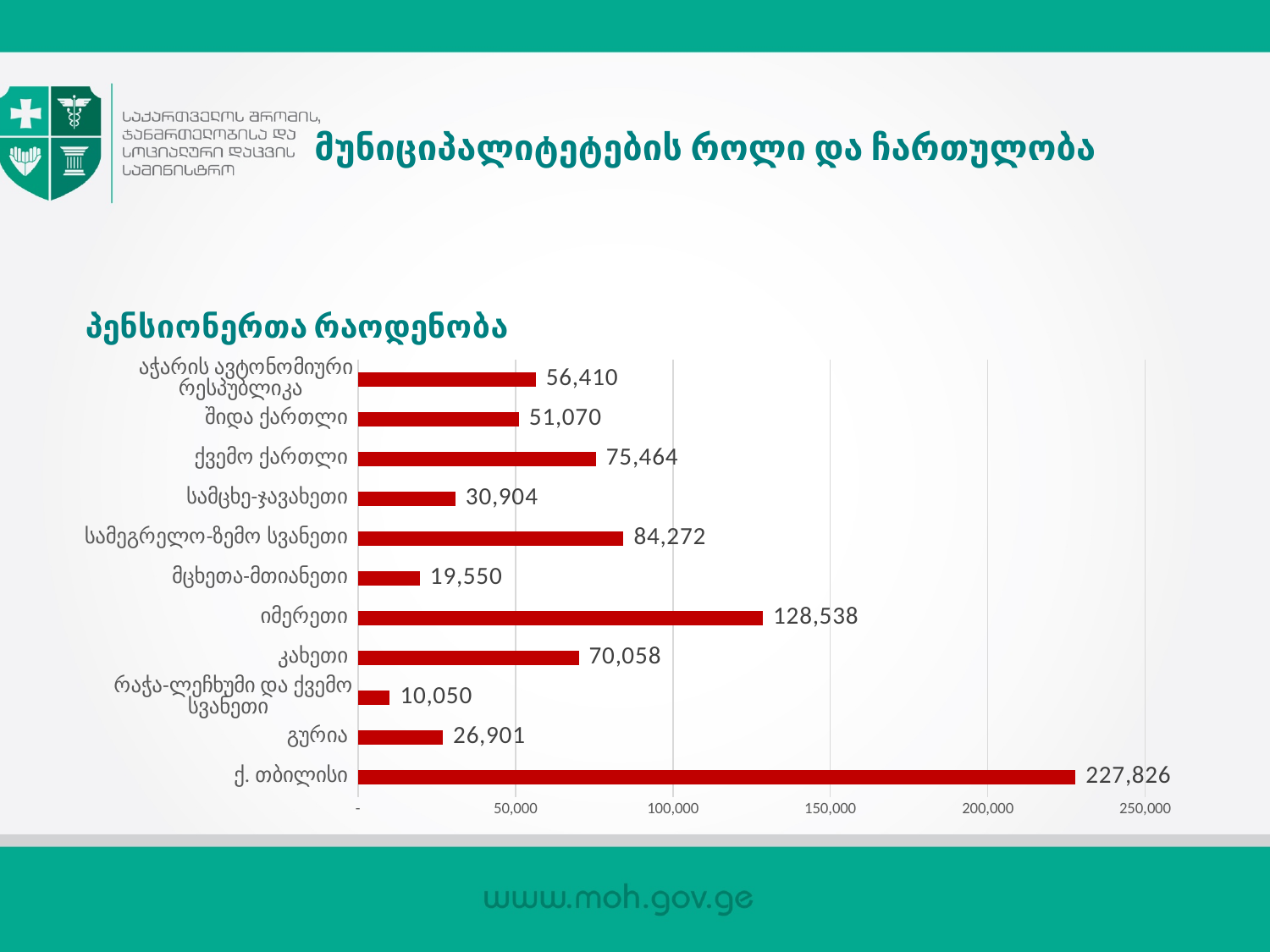
Which category has the highest value? ქ. თბილისი What type of chart is shown on the slide? bar chart What is the difference between the values for ქ. თბილისი and იმერეთი? 99,288 What is the title of the chart? პენსიონერთა რაოდენობა What is the value for რაჭა-ლეჩხუმი და ქვემო სვანეთი? 10,050 Which category has the lowest value? რაჭა-ლეჩხუმი და ქვემო სვანეთი Is the value for გურია greater or less than 50,000? less How many categories are shown in the chart? 11 What is the value for სამეგრელო-ზემო სვანეთი? 84,272 What is the value for ქ. თბილისი? 227,826 What is the value for იმერეთი? 128,538 Which is larger, the value for ქვემო ქართლი or the value for კახეთი? ქვემო ქართლი